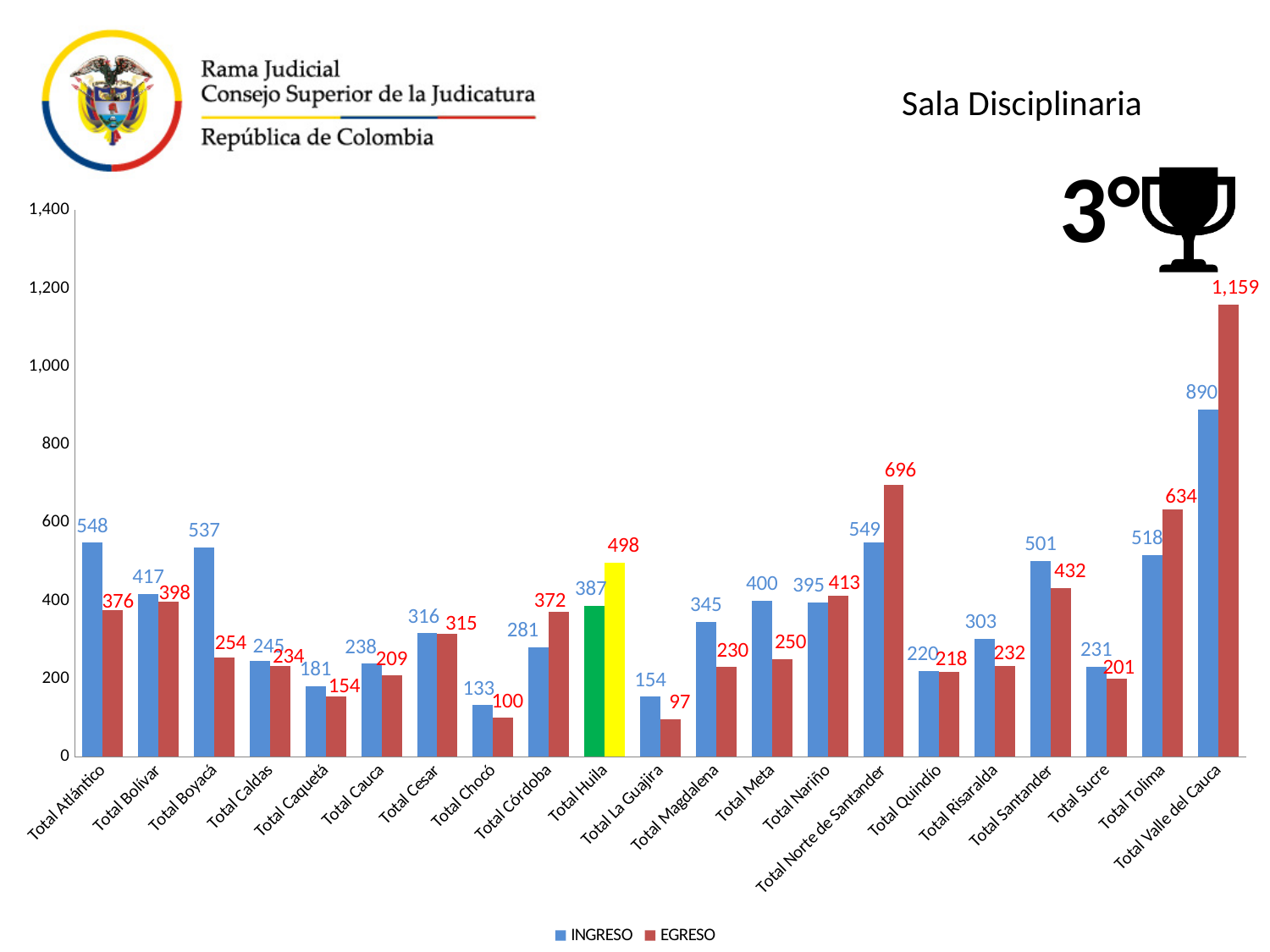
Which is larger for Total Tolima, INGRESO or EGRESO? EGRESO What is the EGRESO value for Total Norte de Santander? 696 What is the difference between the EGRESO and INGRESO values for Total Valle del Cauca? 269 How many series does the legend list? 2 What is the INGRESO value for Total Huila? 387 What kind of chart is shown on the slide? Bar chart Which category has the highest EGRESO value? Total Valle del Cauca Which is larger for Total Boyacá, INGRESO or EGRESO? INGRESO What is the INGRESO value for Total Valle del Cauca? 890 Which category has the lowest INGRESO value? Total Chocó Which category has the lowest EGRESO value? Total La Guajira How many categories are shown on the x axis? 21